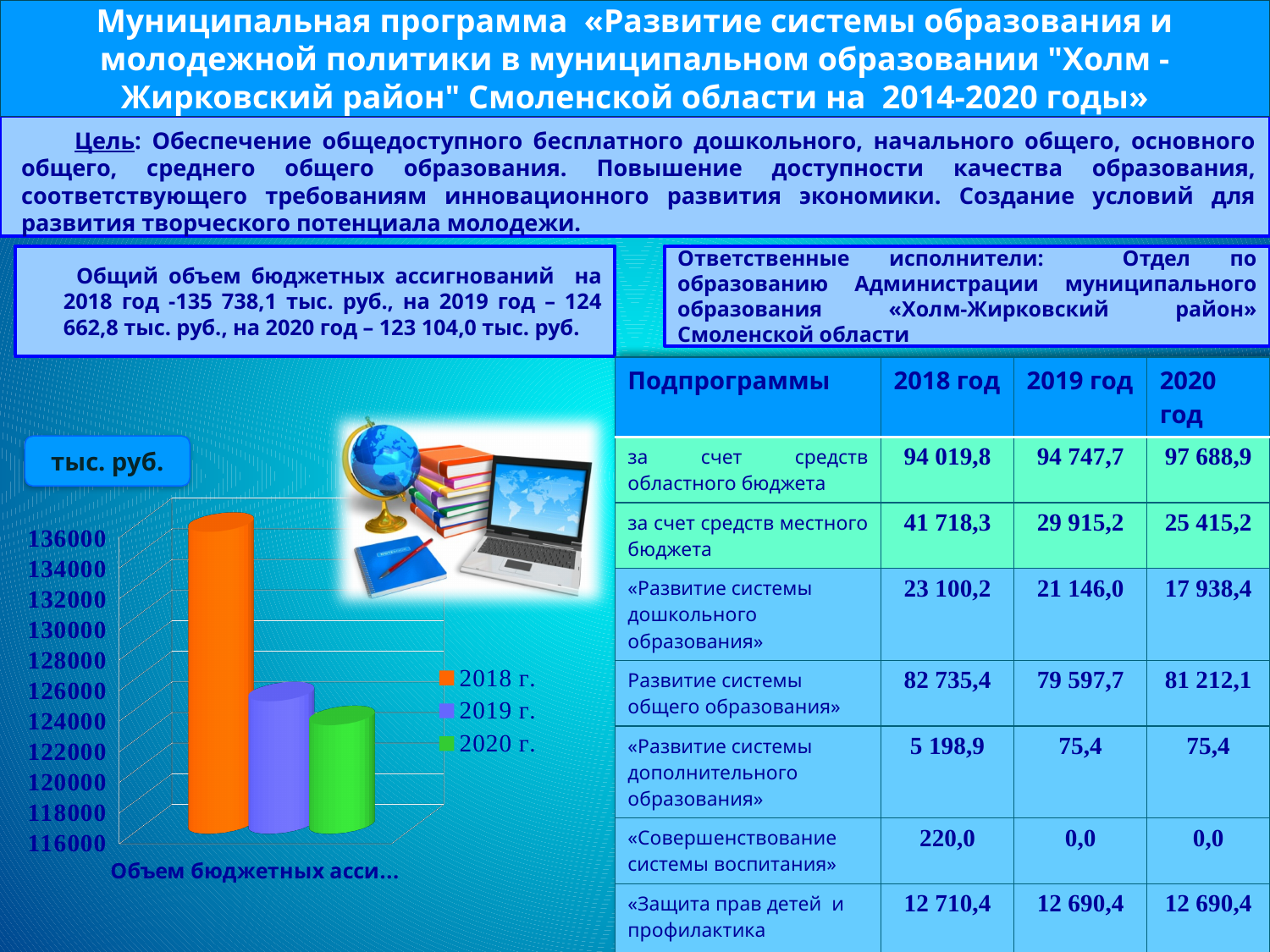
Which bar is taller in the chart, 2019 г. or 2020 г.? 2019 г. What colour is the bar for 2018 г. in the chart? orange Is the value for 2020 г. in the chart greater or less than 126000? less Is the value for 2018 г. in the chart greater or less than 134000? greater Which bar is taller in the chart, 2018 г. or 2019 г.? 2018 г. Is the value for 2019 г. in the chart greater or less than 120000? greater How many bars are plotted in the chart? 3 Which year has the lowest bar in the chart? 2020 г. How many series does the chart legend list? 3 Do the bar values rise or fall from 2018 г. to 2020 г. in the chart? fall What kind of chart is shown on the slide? bar chart Which year has the highest bar in the chart? 2018 г.